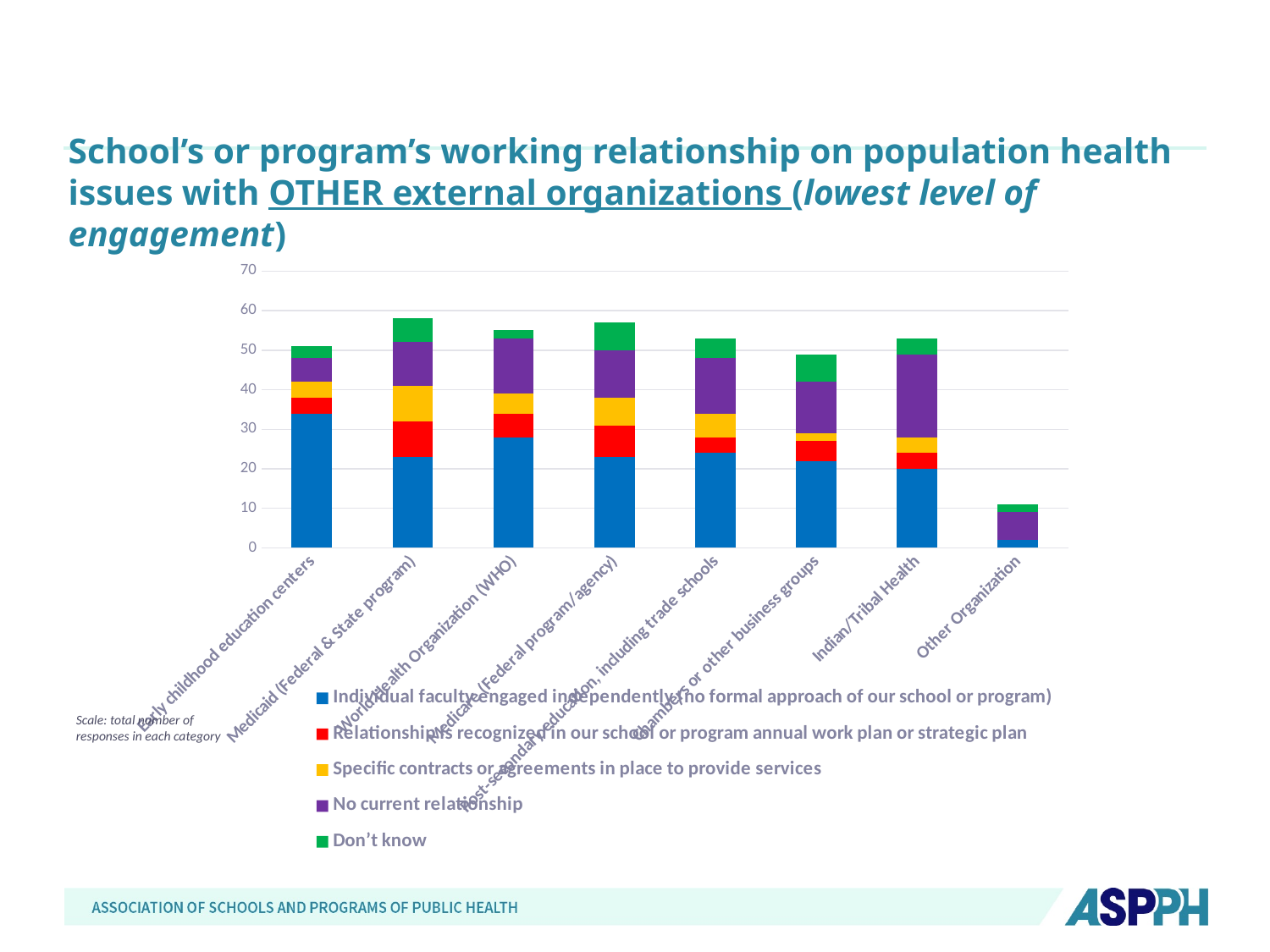
Which category has the lowest total number of responses? Other Organization Which has a larger 'No current relationship' segment: Indian/Tribal Health or Early childhood education centers? Indian/Tribal Health What kind of chart is shown on the slide? Stacked bar chart Which colour represents 'Don't know' in the legend? Green Is the 'Individual faculty engaged independently' value for Other Organization greater or less than 10? less Is the total number of responses for Medicaid (Federal & State program) greater or less than 50? greater Which category has the largest 'Individual faculty engaged independently' segment? Early childhood education centers How many categories are shown along the x axis? 8 How many series does the legend list? 5 What does the scale note say the values represent? Total number of responses in each category Is the total number of responses for Other Organization greater or less than 20? less